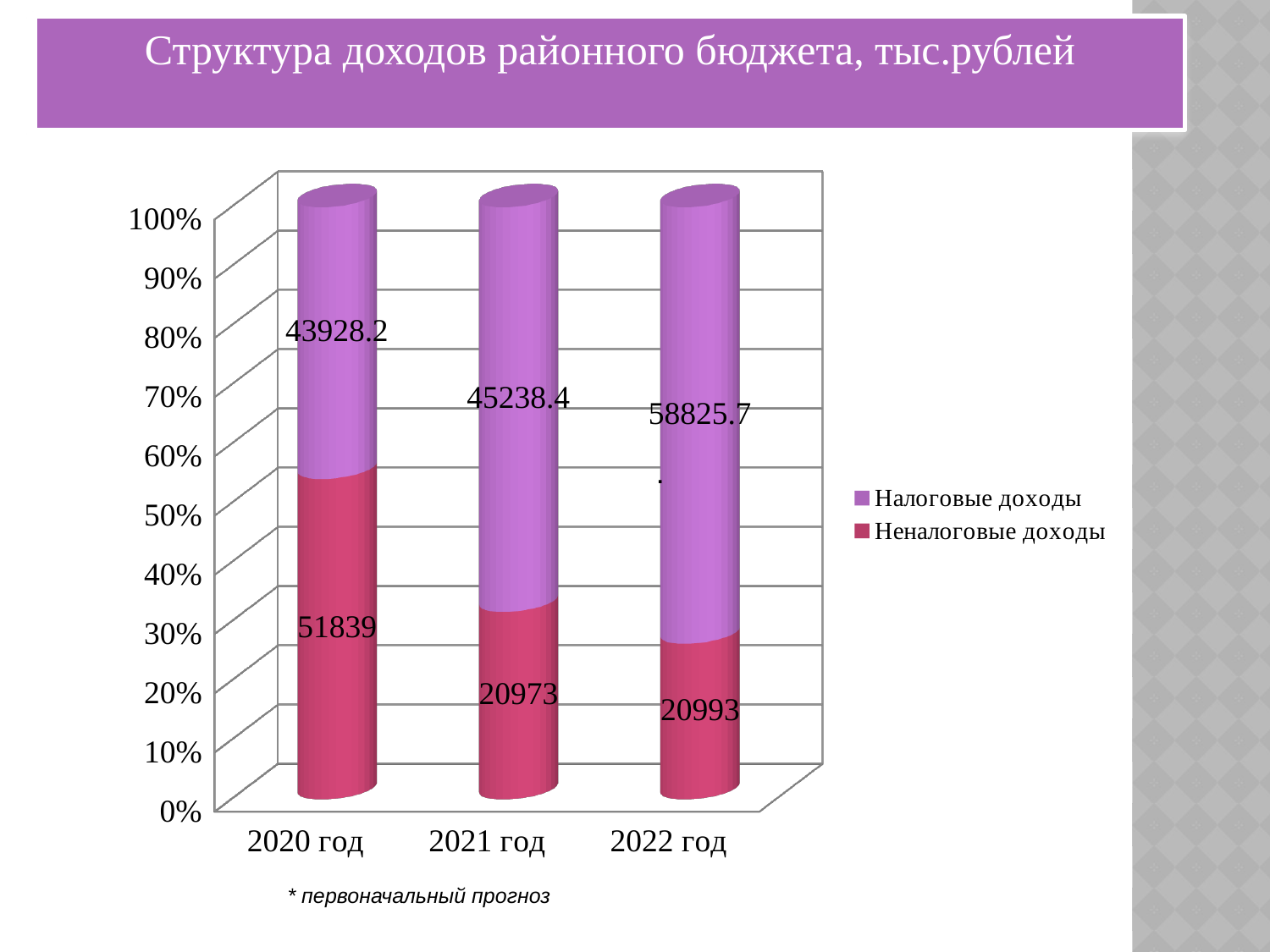
How many series does the legend list? 2 What is the value of Неналоговые доходы for 2021 год? 20973 In which year is Неналоговые доходы the highest? 2020 год What is the value of Налоговые доходы for 2022 год? 58825.7 In which year is Налоговые доходы the highest? 2022 год Does Налоговые доходы rise or fall from 2020 год to 2022 год? rise What is the total of the 2020 год bar (Налоговые доходы plus Неналоговые доходы)? 95767.2 Which is larger in 2020 год: Налоговые доходы or Неналоговые доходы? Неналоговые доходы What is the value of Неналоговые доходы for 2022 год? 20993 What is the difference between Налоговые доходы in 2022 год and in 2021 год? 13587.3 How many years are shown on the x axis? 3 What is the value of Налоговые доходы for 2020 год? 43928.2